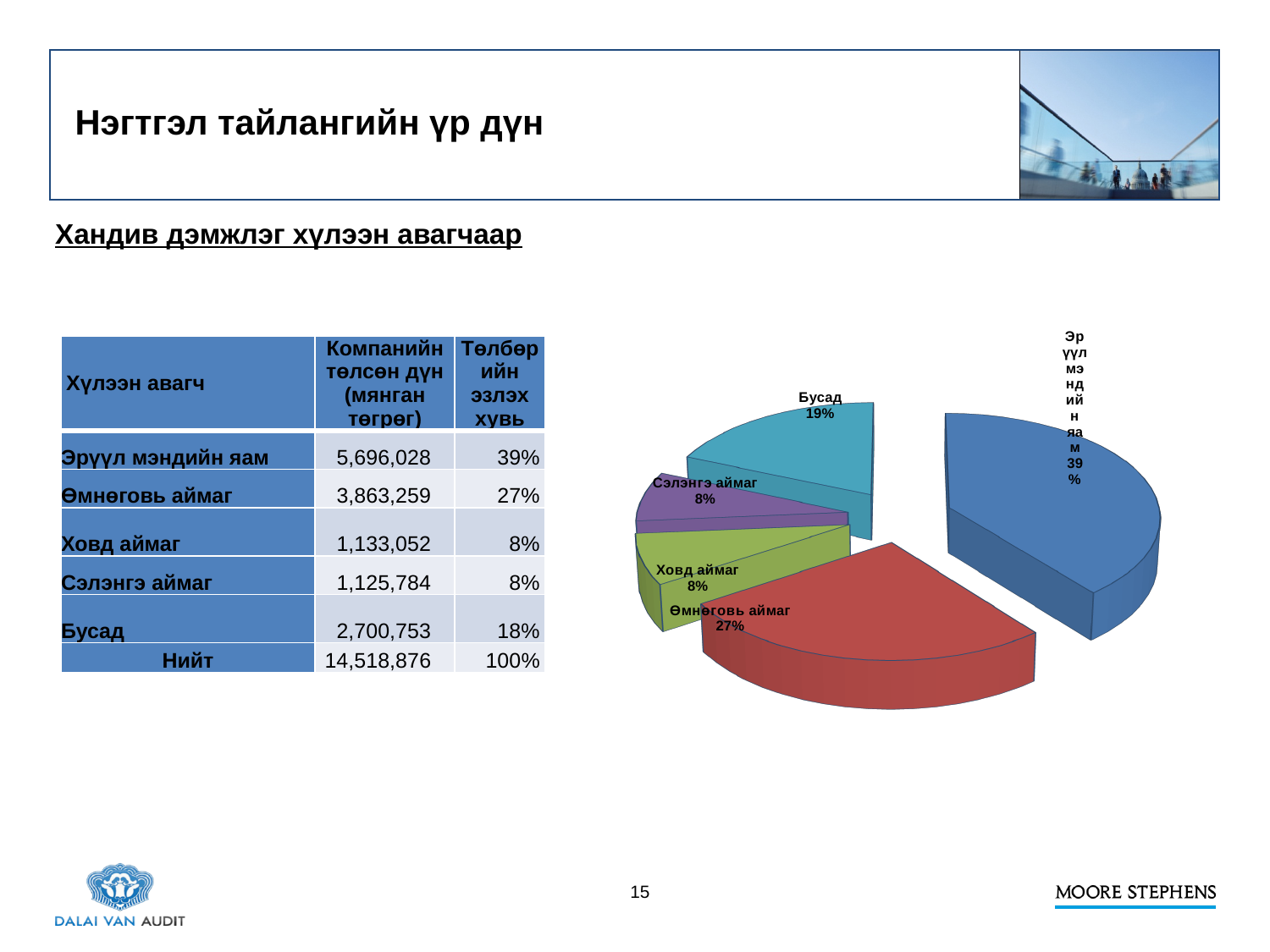
Which slice of the pie chart is the largest? Эрүүл мэндийн яам What kind of chart is shown on the slide? pie chart What share of the pie does Ховд аймаг hold? 8% What is the difference in percentage points between the Эрүүл мэндийн яам slice and the Өмнөговь аймаг slice? 12 What share of the pie does Өмнөговь аймаг hold? 27% What colour is the Өмнөговь аймаг slice in the pie chart? red How many slices does the pie chart have? 5 What percentage is labelled on the Бусад slice of the pie chart? 19% Which is larger in the pie chart, Бусад or Ховд аймаг? Бусад What share of the pie does Сэлэнгэ аймаг hold? 8% Which is larger in the pie chart, Өмнөговь аймаг or Бусад? Өмнөговь аймаг